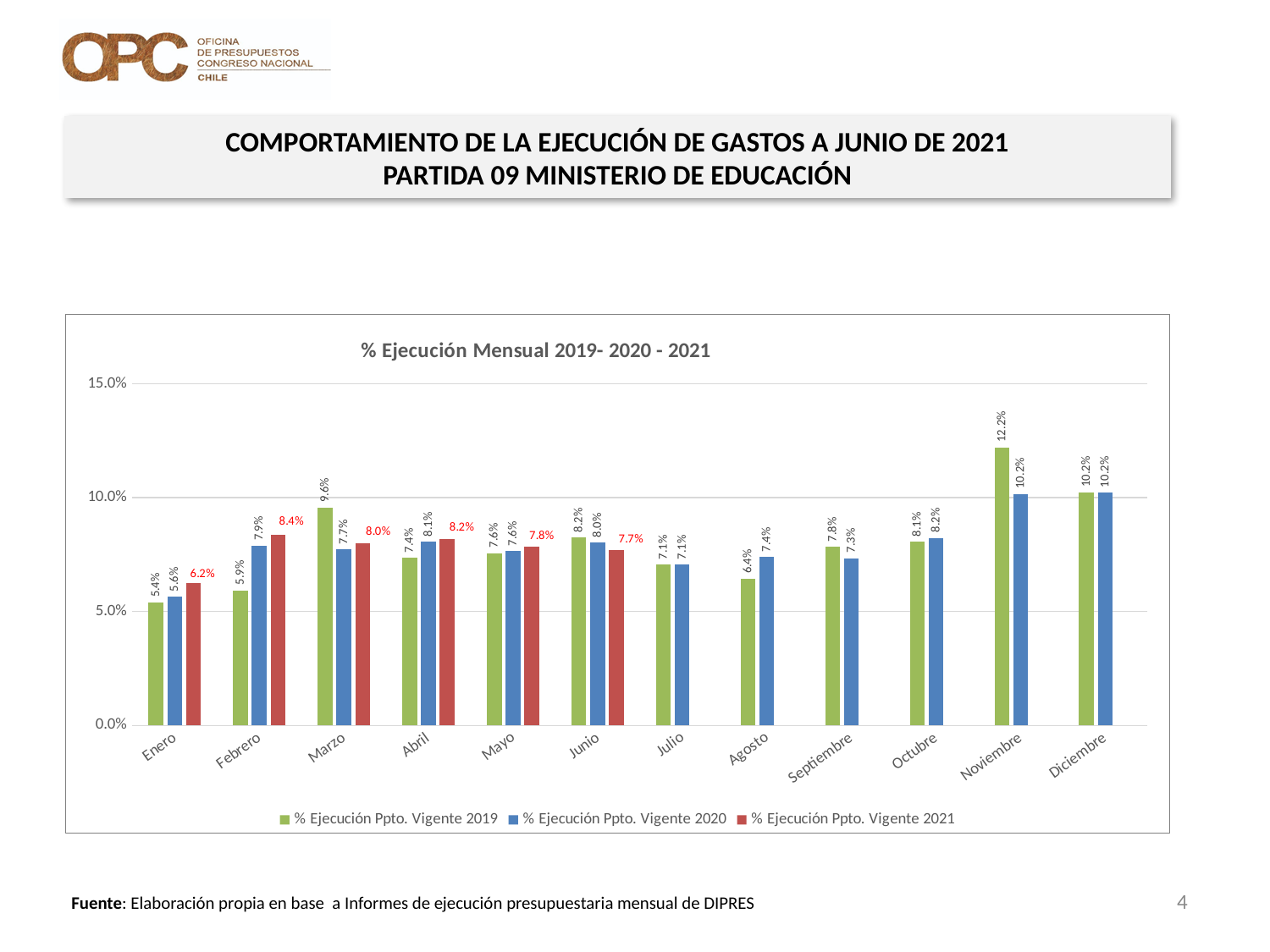
What is the difference between the 2019 and 2020 values for Noviembre? 2.0% Which is larger for Junio: the 2019 value or the 2021 value? 2019 value How many months are shown on the x axis? 12 Is the value of % Ejecución Ppto. Vigente 2019 for Diciembre greater or less than 10.0%? greater Which month has the highest value for % Ejecución Ppto. Vigente 2019? Noviembre What is the value of % Ejecución Ppto. Vigente 2020 for Agosto? 7.4% What is the title of the chart? % Ejecución Mensual 2019- 2020 - 2021 What is the value of % Ejecución Ppto. Vigente 2019 for Marzo? 9.6% Which month has the lowest value for % Ejecución Ppto. Vigente 2020? Enero How many series does the legend list? 3 What type of chart is shown on the slide? bar chart What is the value of % Ejecución Ppto. Vigente 2021 for Febrero? 8.4%